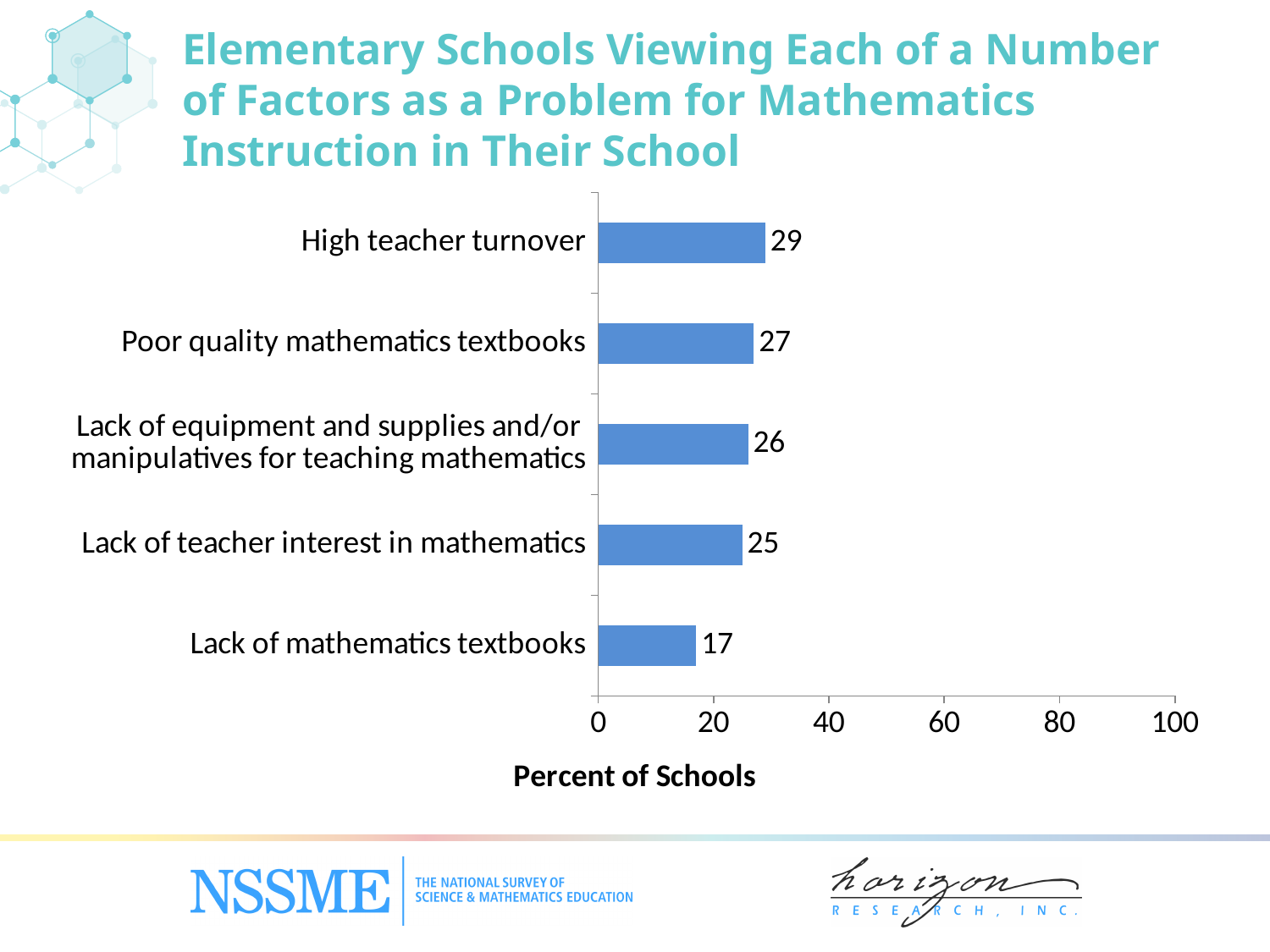
What is the difference between the values for 'High teacher turnover' and 'Lack of mathematics textbooks'? 12 What is the value for 'Poor quality mathematics textbooks'? 27 How many factors are shown in the chart? 5 What percent of schools view high teacher turnover as a problem for mathematics instruction? 29 What is the value for 'Lack of teacher interest in mathematics'? 25 What is the label of the horizontal axis? Percent of Schools Which factor has the lowest percent of schools viewing it as a problem? Lack of mathematics textbooks What is the value for 'Lack of mathematics textbooks'? 17 Which is larger: the value for 'Poor quality mathematics textbooks' or the value for 'Lack of mathematics textbooks'? Poor quality mathematics textbooks Which factor has the highest percent of schools viewing it as a problem? High teacher turnover What kind of chart is shown on the slide? Bar chart Is the value for 'Lack of equipment and supplies and/or manipulatives for teaching mathematics' greater or less than 40? less